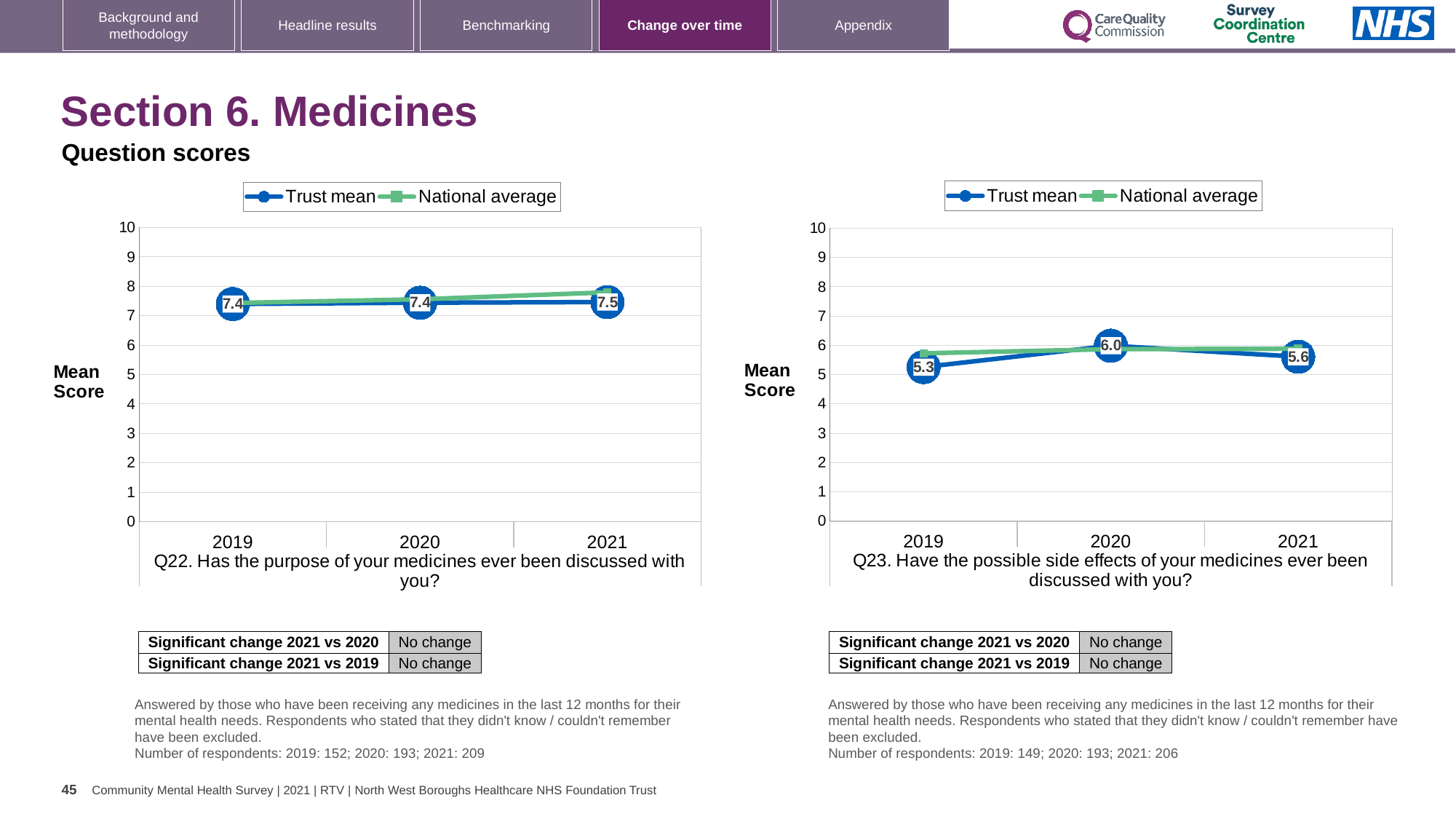
In the right chart (Q23), which year has the highest Trust mean? 2020 In the right chart (Q23), what is the Trust mean for 2020? 6.0 How many series does the legend of the left chart (Q22) list? 2 In the left chart (Q22), what is the Trust mean for 2021? 7.5 What type of chart is the left chart (Q22)? Line chart In the right chart (Q23), which year has the lowest Trust mean? 2019 In the left chart (Q22), is the Trust mean for 2020 greater or less than 8? less In the right chart (Q23), what is the difference between the Trust mean for 2020 and 2019? 0.7 In the right chart (Q23), what is the Trust mean for 2019? 5.3 In the right chart (Q23), is the Trust mean for 2021 greater or less than 5? greater How many years are plotted on the x axis of the right chart (Q23)? 3 In the left chart (Q22), what is the Trust mean for 2019? 7.4